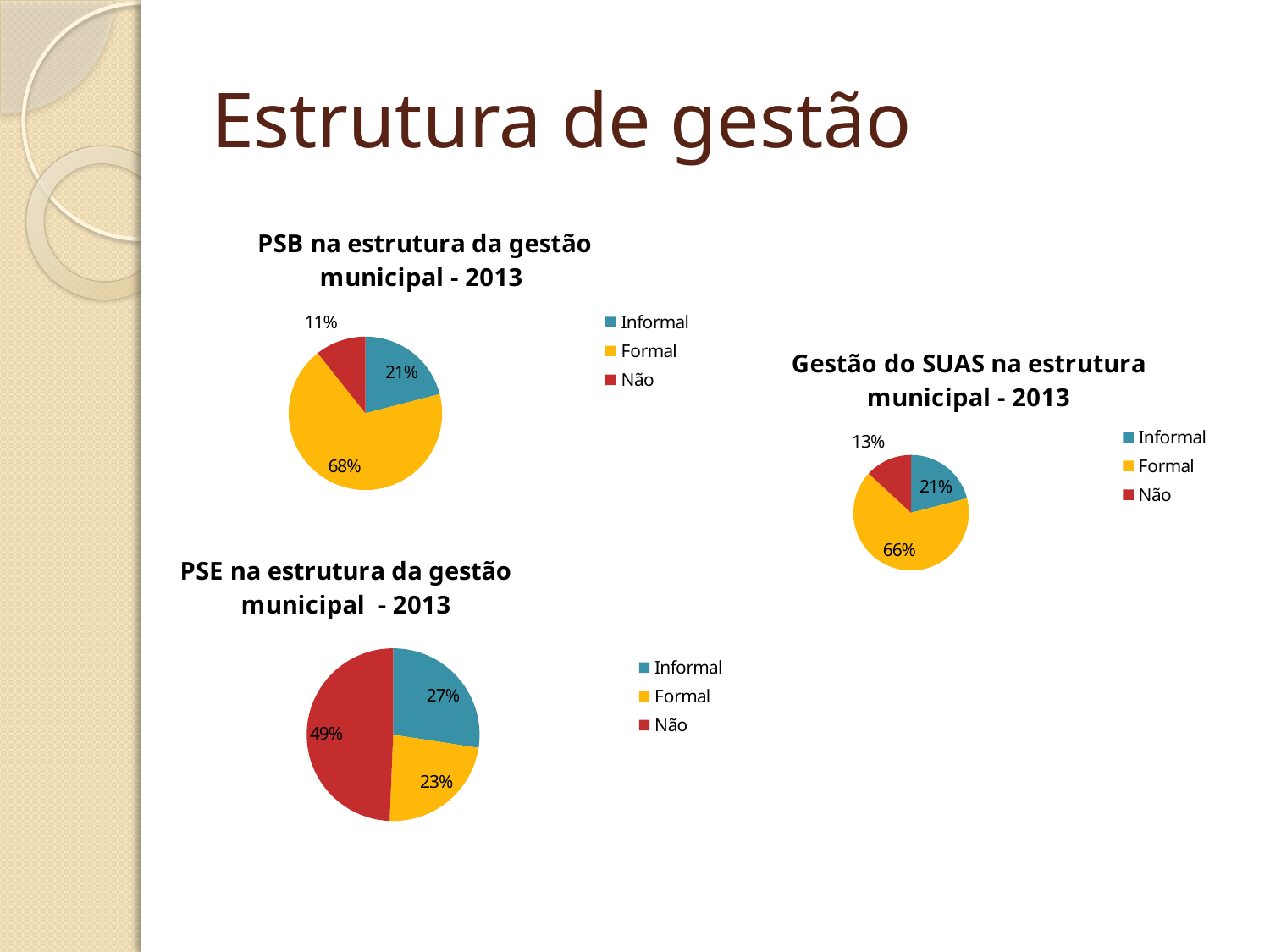
In the chart 'PSB na estrutura da gestão municipal - 2013', what share does Formal have? 68% In the chart 'PSE na estrutura da gestão municipal - 2013', what share does Informal have? 27% In the chart 'Gestão do SUAS na estrutura municipal - 2013', what share does Não have? 13% In the chart 'PSE na estrutura da gestão municipal - 2013', what is the difference between the Informal and Formal shares? 4% In the chart 'PSE na estrutura da gestão municipal - 2013', what share does Não have? 49% In the chart 'PSB na estrutura da gestão municipal - 2013', which category has the largest slice? Formal What kind of chart is 'PSE na estrutura da gestão municipal - 2013'? Pie chart In the chart 'PSE na estrutura da gestão municipal - 2013', which category has the largest slice? Não In the chart 'PSB na estrutura da gestão municipal - 2013', which category has the smallest slice? Não In the chart 'Gestão do SUAS na estrutura municipal - 2013', what share does Formal have? 66% In the chart 'Gestão do SUAS na estrutura municipal - 2013', which is larger, Informal or Não? Informal In the chart 'PSB na estrutura da gestão municipal - 2013', what share does Não have? 11%